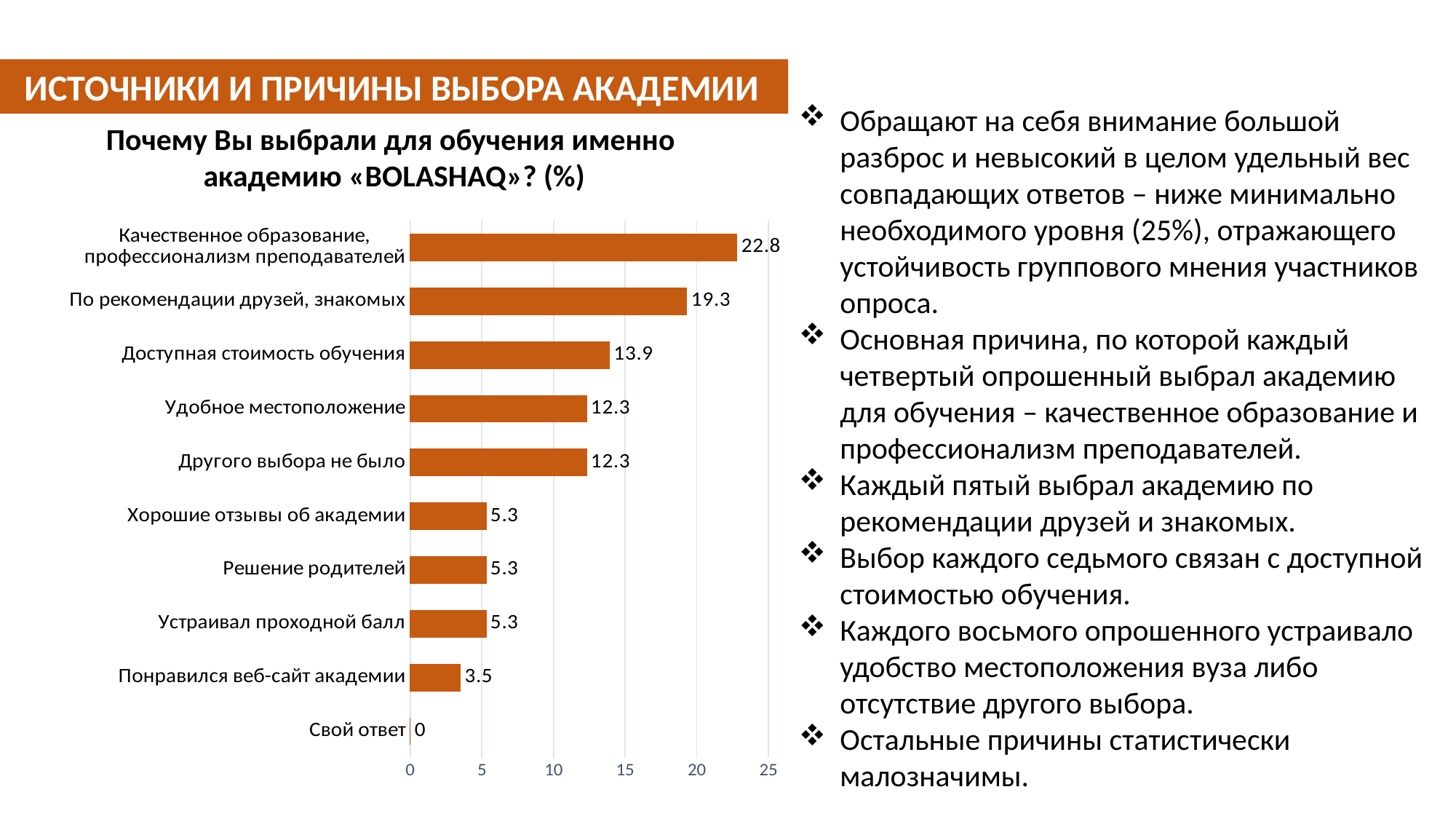
What is the difference between the values for «Качественное образование, профессионализм преподавателей» and «По рекомендации друзей, знакомых»? 3.5 Which category has the lowest value? Свой ответ Which category has the highest value? Качественное образование, профессионализм преподавателей What value is shown for «Понравился веб-сайт академии»? 3.5 Is the value for «По рекомендации друзей, знакомых» greater or less than 15? greater How many categories are shown in the chart? 10 What value is shown for «Качественное образование, профессионализм преподавателей»? 22.8 What kind of chart is shown on the slide? Bar chart What value is shown for «Доступная стоимость обучения»? 13.9 What is the title of the chart? Почему Вы выбрали для обучения именно академию «BOLASHAQ»? (%) Which is larger: the value for «Доступная стоимость обучения» or for «Удобное местоположение»? Доступная стоимость обучения What value is shown for «По рекомендации друзей, знакомых»? 19.3